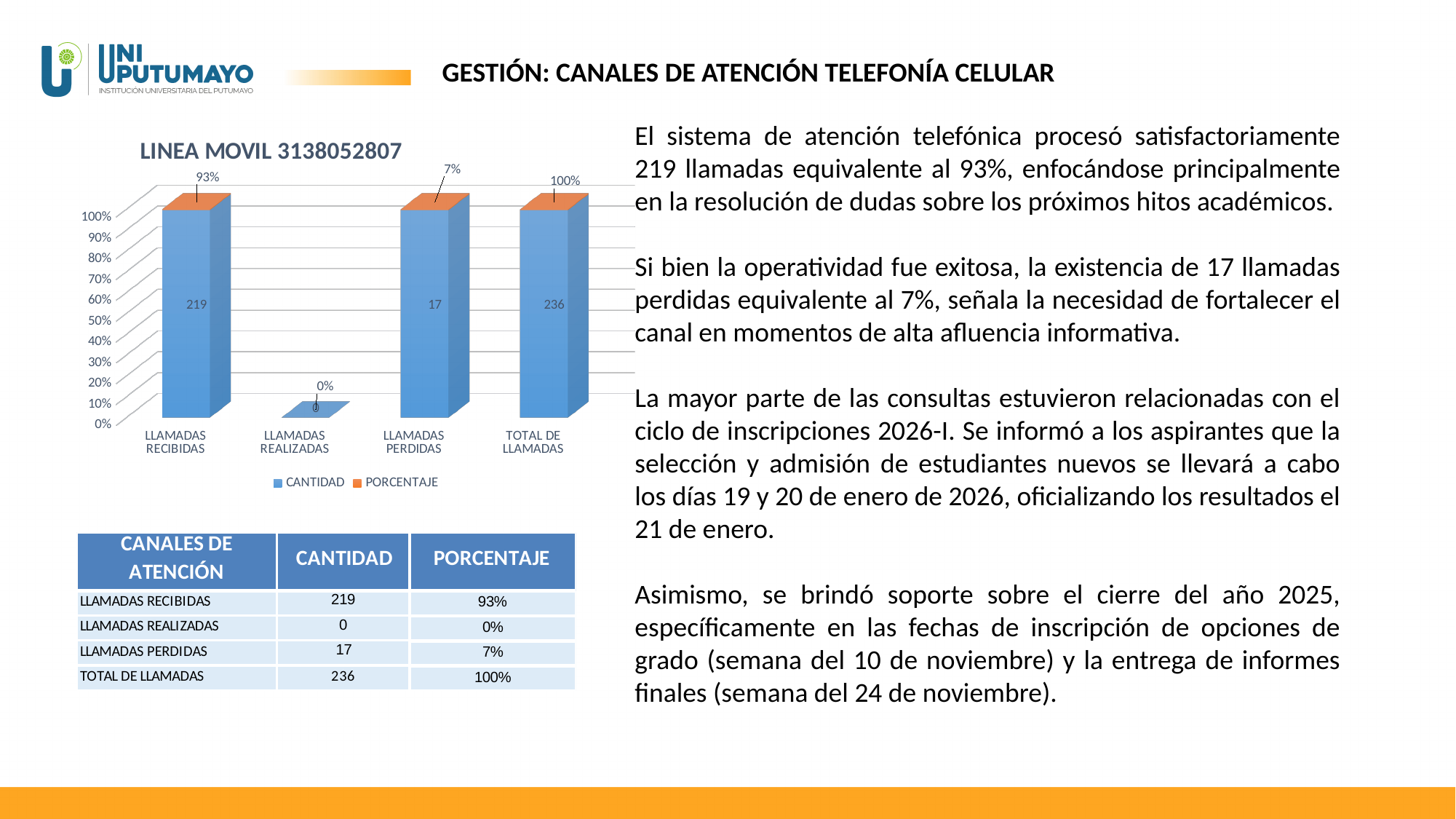
What is the CANTIDAD value for LLAMADAS RECIBIDAS? 219 What is the difference between the CANTIDAD values for LLAMADAS RECIBIDAS and LLAMADAS PERDIDAS? 202 Which is larger, the PORCENTAJE for LLAMADAS RECIBIDAS or for LLAMADAS PERDIDAS? LLAMADAS RECIBIDAS Which category has the highest CANTIDAD value? TOTAL DE LLAMADAS What type of chart is shown on the slide? bar chart What is the title of the chart? LINEA MOVIL 3138052807 How many series does the chart legend list? 2 Which category has the lowest CANTIDAD value? LLAMADAS REALIZADAS What is the PORCENTAJE value for LLAMADAS PERDIDAS? 7% How many categories are shown on the x axis of the chart? 4 What is the CANTIDAD value for LLAMADAS REALIZADAS? 0 What is the PORCENTAJE value for TOTAL DE LLAMADAS? 100%